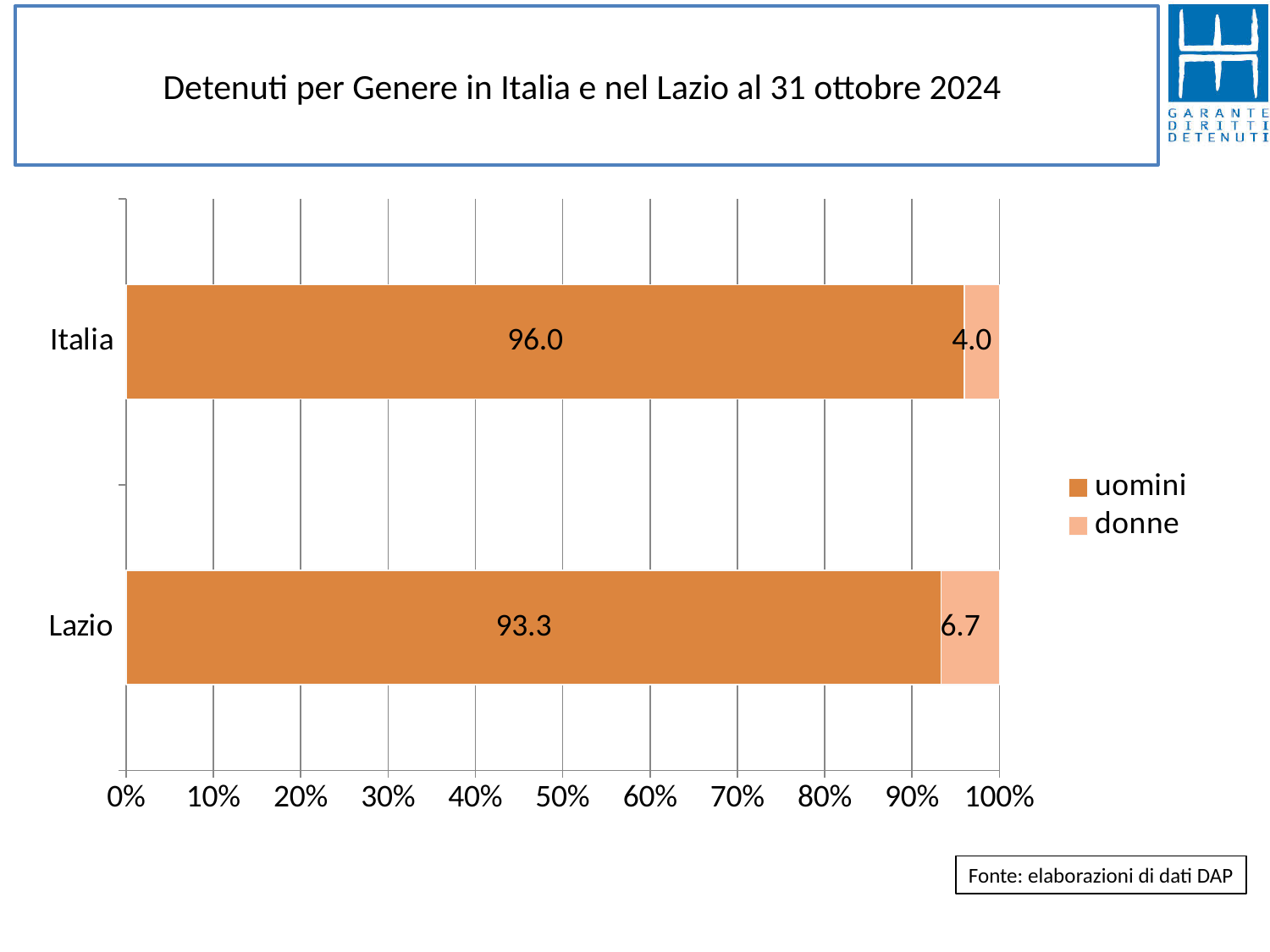
What is the value for uomini in Italia? 96.0 Which category has the higher value for donne, Italia or Lazio? Lazio What is the title of the chart? Detenuti per Genere in Italia e nel Lazio al 31 ottobre 2024 What kind of chart is shown on the slide? Stacked bar chart Which category has the lowest value for uomini? Lazio What is the difference between the uomini values for Italia and Lazio? 2.7 What is the difference between the donne values for Lazio and Italia? 2.7 What is the value for donne in Lazio? 6.7 What is the value for uomini in Lazio? 93.3 How many categories are shown on the chart? 2 How many series does the legend list? 2 What is the value for donne in Italia? 4.0